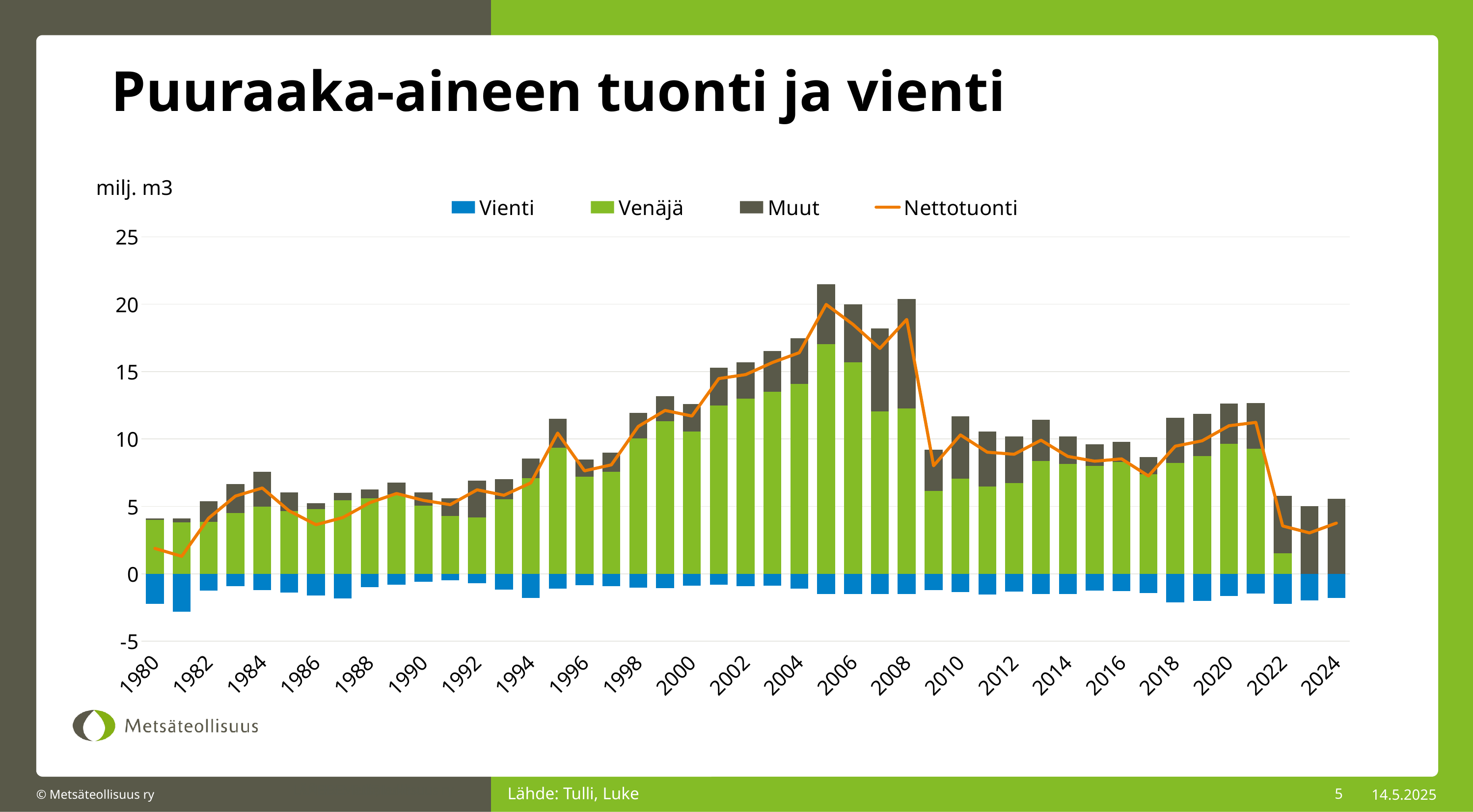
What are the series names listed in the legend? Vienti, Venäjä, Muut, Nettotuonti How many years are plotted along the x axis, from 1980 to 2024? 45 Is the Nettotuonti value for 2022 greater or less than 5? less How many series does the legend list? 4 In which year is the total stacked import bar (Venäjä plus Muut) the tallest? 2005 Is the Nettotuonti value for 2008 greater or less than 15? greater Is the Venäjä value for 2005 greater or less than 15? greater What unit is shown on the y axis of the chart? milj. m3 Does the Nettotuonti line rise or fall from 2021 to 2022? Fall Which is larger, the Venäjä value for 2005 or for 2010? 2005 What kind of chart is shown on the slide? A stacked bar chart with a line